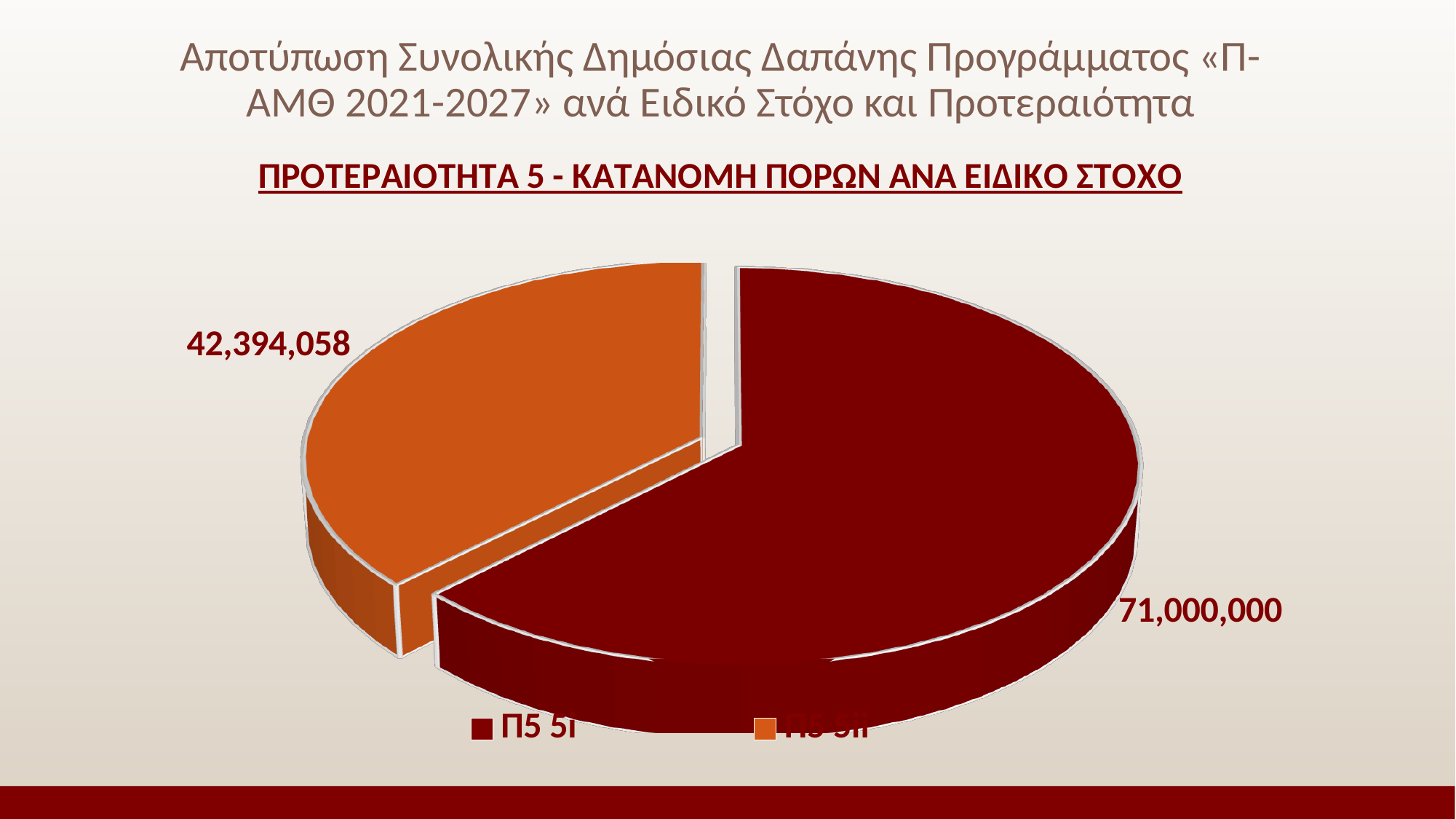
What is the chart's title? ΠΡΟΤΕΡΑΙΟΤΗΤΑ 5 - ΚΑΤΑΝΟΜΗ ΠΟΡΩΝ ΑΝΑ ΕΙΔΙΚΟ ΣΤΟΧΟ What type of chart is shown on the slide? pie chart Which category has the smallest slice of the pie? Π5 5ii What is the value for Π5 5ii? 42,394,058 What is the total of all slices in the pie chart? 113,394,058 What is the difference between the values for Π5 5i and Π5 5ii? 28,605,942 How many slices does the pie chart have? 2 What is the value for Π5 5i? 71,000,000 How many entries does the legend list? 2 What colour is the slice for Π5 5ii? orange Which is larger, the value for Π5 5i or the value for Π5 5ii? Π5 5i Which category has the largest slice of the pie? Π5 5i